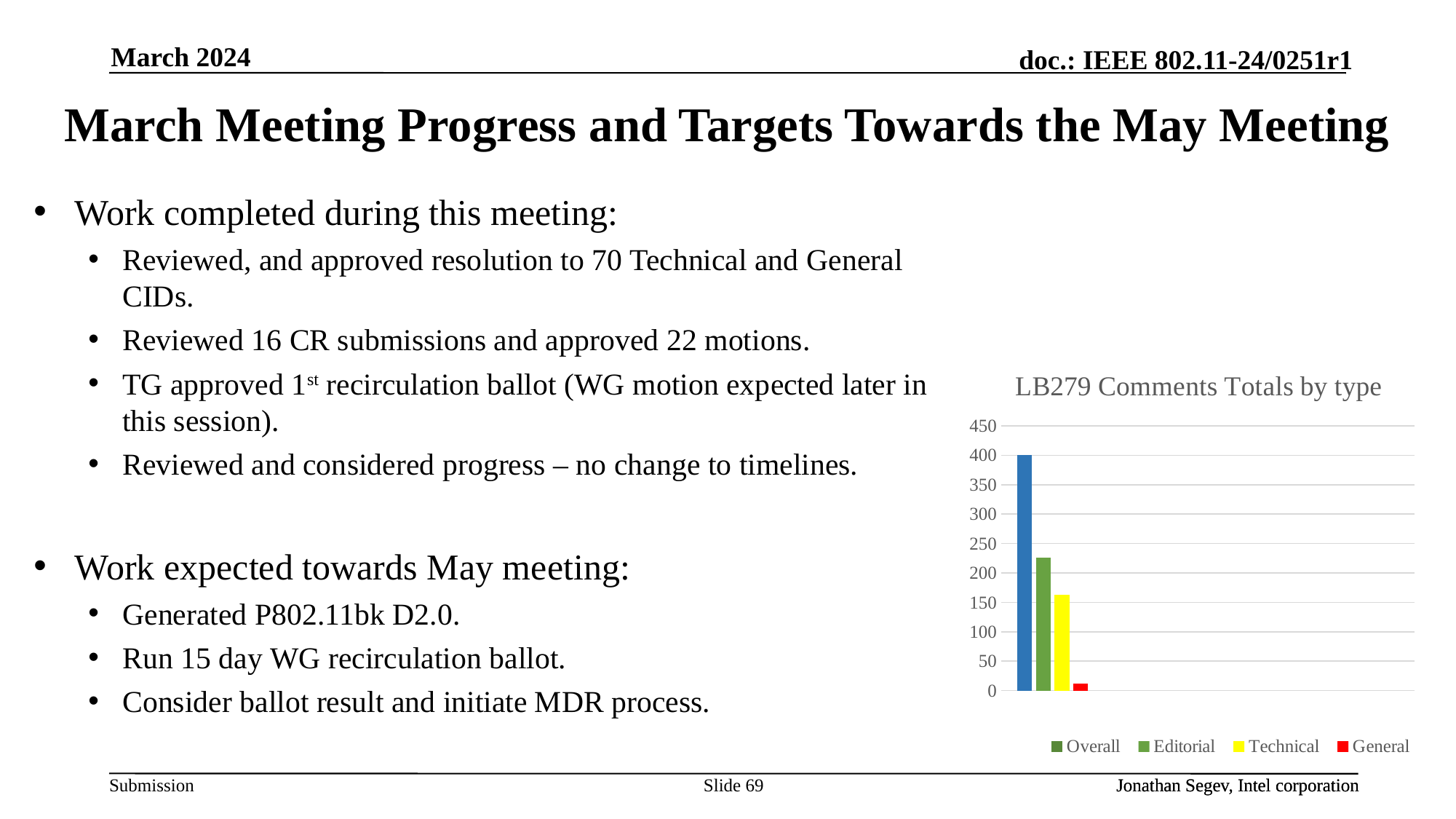
Is the value for Overall greater or less than 350? greater How many series does the chart legend list? 4 Is the value for Technical greater or less than 200? less What is the highest value shown on the vertical axis of the chart? 450 Is the value for Editorial greater or less than 200? greater What kind of chart is shown on the slide? bar chart What is the title of the chart? LB279 Comments Totals by type Which is larger, the value for Editorial or the value for Technical? Editorial Which series has the highest value in the chart? Overall Which series has the lowest value in the chart? General Which is larger, the value for Technical or the value for General? Technical